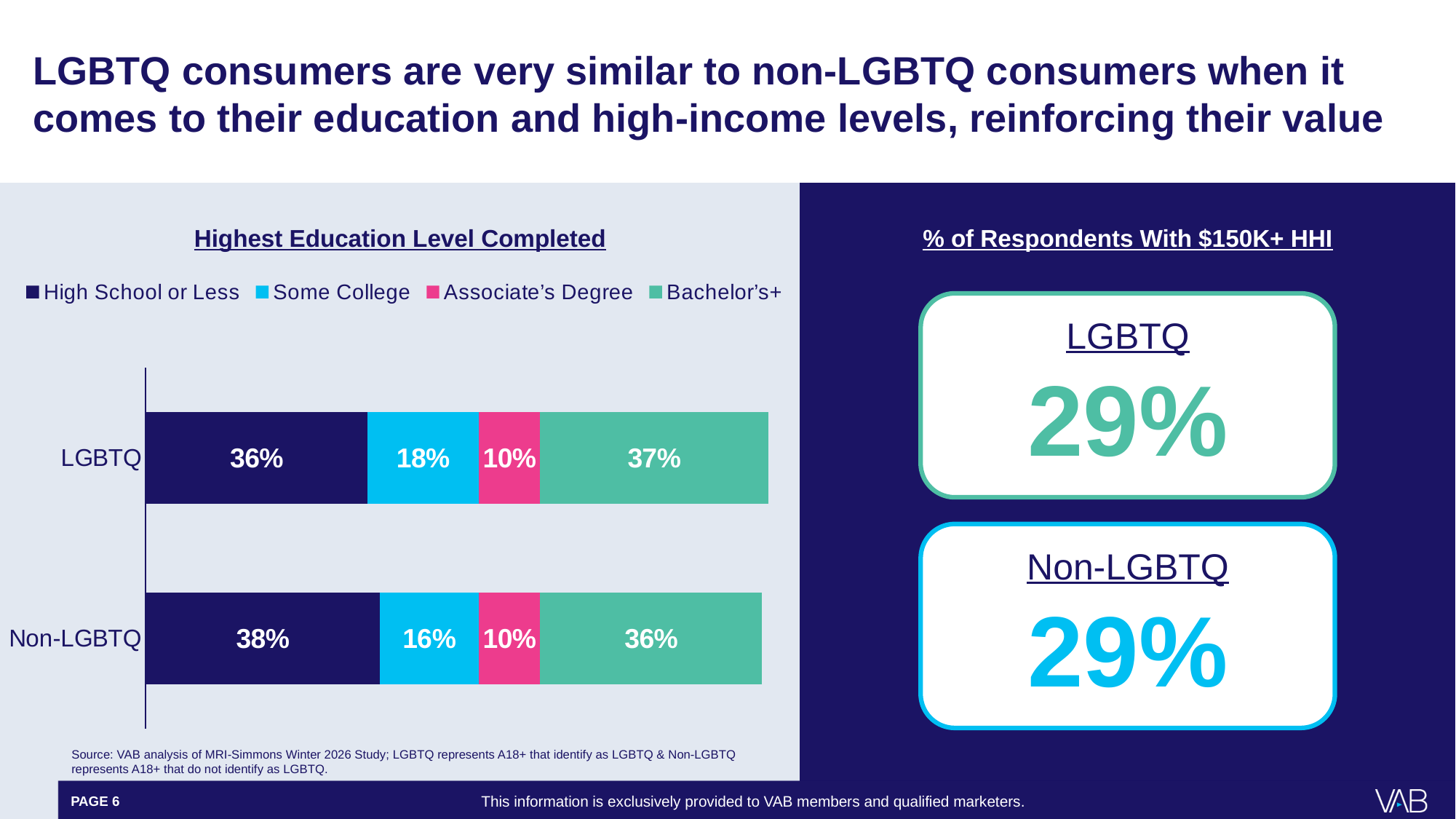
In the Highest Education Level Completed chart, what is the total of the Non-LGBTQ bar's segments? 100% In the Highest Education Level Completed chart, which education level has the smallest share among Non-LGBTQ respondents? Associate's Degree In the Highest Education Level Completed chart, which group has the larger Some College share, LGBTQ or Non-LGBTQ? LGBTQ How many groups (bars) are shown in the Highest Education Level Completed chart? 2 What kind of chart is the Highest Education Level Completed chart? Stacked bar chart In the Highest Education Level Completed chart, how much higher is the High School or Less share for Non-LGBTQ than for LGBTQ? 2 percentage points In the Highest Education Level Completed chart, what percentage of LGBTQ respondents have Some College? 18% In the Highest Education Level Completed chart, what is the Bachelor's+ value for LGBTQ? 37% In the Highest Education Level Completed chart, what percentage of Non-LGBTQ respondents have High School or Less? 38% How many series does the legend of the Highest Education Level Completed chart list? 4 In the Highest Education Level Completed chart, what is the Associate's Degree value for Non-LGBTQ? 10% In the Highest Education Level Completed chart, which education level has the largest share among LGBTQ respondents? Bachelor's+